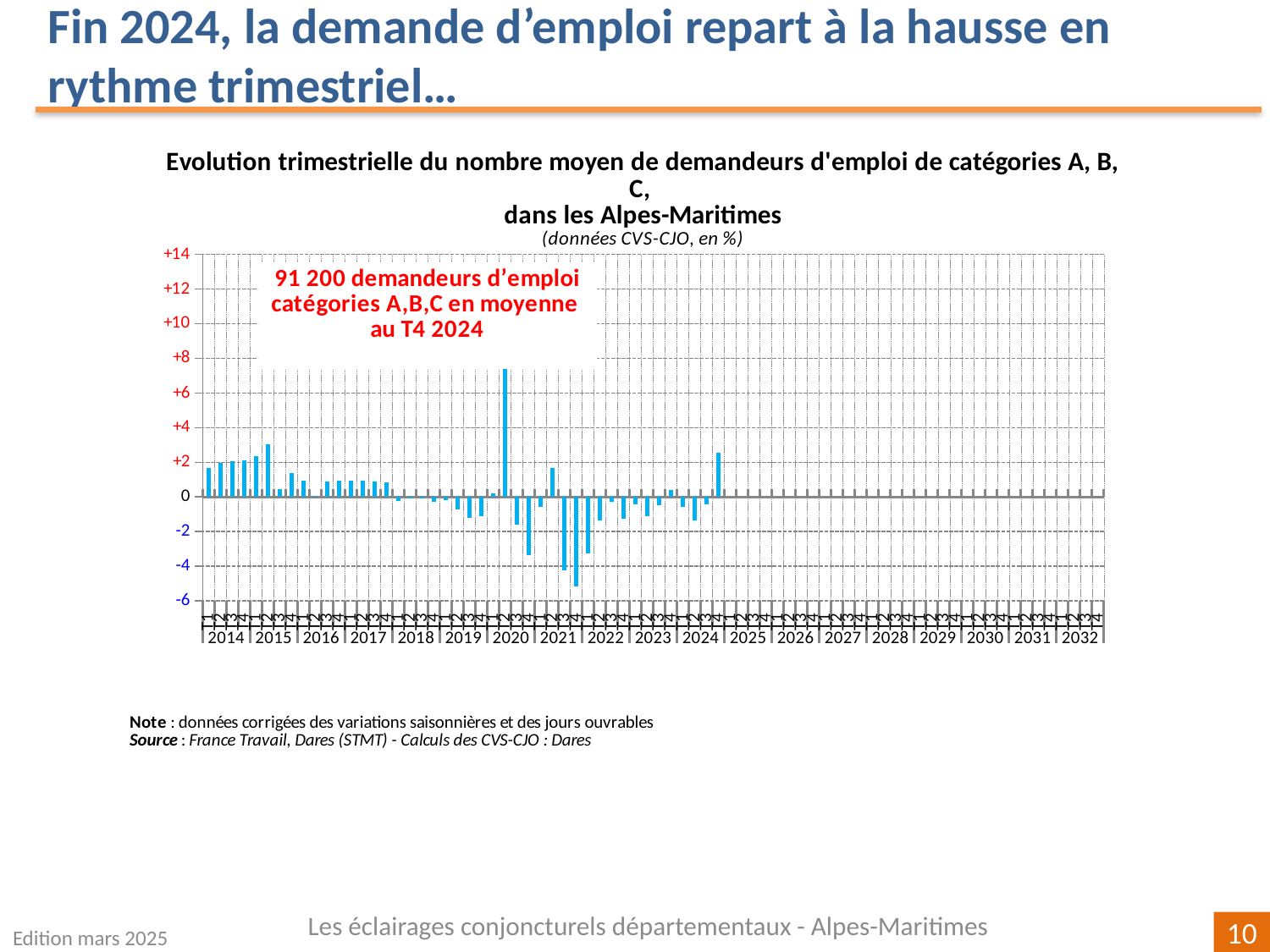
Which is larger: the value for T2 2020 or the value for T4 2024? T2 2020 How many years are labelled along the horizontal axis of the chart? 19 Is the value of the lowest bar (in 2021) greater or less than -4? less What kind of chart is shown on the slide? Bar chart In which year does the lowest (most negative) bar of the chart occur? 2021 In which year does the tallest bar of the chart occur? 2020 What is the highest value shown on the vertical axis? +14 Is the value for T4 2024, the last plotted bar, greater or less than 0? greater Is the value for T2 2015 greater or less than +4? less Are the bars for the four quarters of 2019 above or below zero? below According to the annotation on the chart, how many demandeurs d'emploi catégories A,B,C were there on average in T4 2024? 91 200